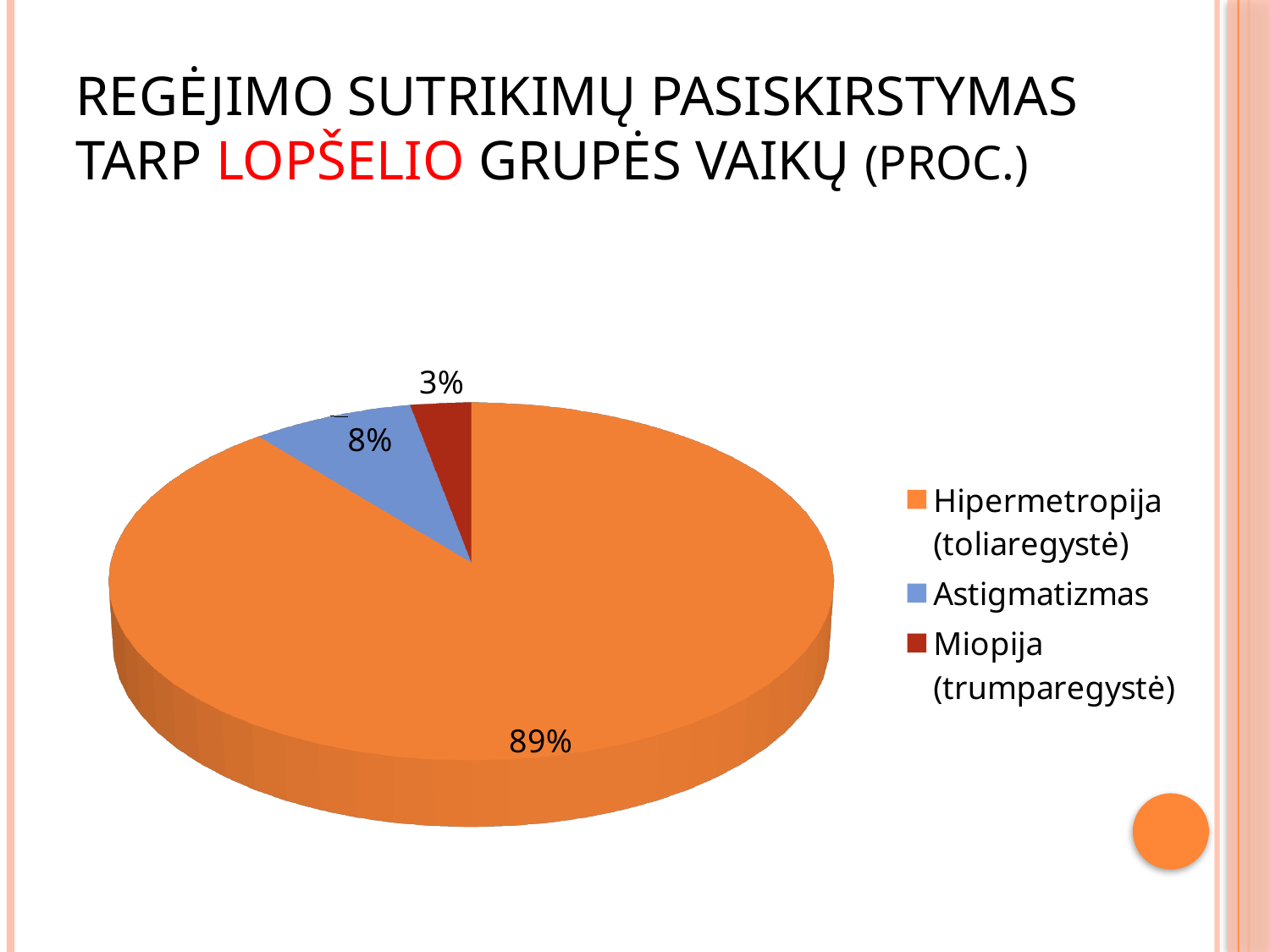
What is the difference in percentage points between Astigmatizmas and Miopija (trumparegystė)? 5 Which category has the smallest share of the pie? Miopija (trumparegystė) What percentage of the pie is Hipermetropija (toliaregystė)? 89% What percentage of the pie is Astigmatizmas? 8% How many categories does the pie chart have? 3 What colour is the slice for Astigmatizmas? blue Which category has the largest share of the pie? Hipermetropija (toliaregystė) What percentage of the pie is Miopija (trumparegystė)? 3% How many entries does the legend list? 3 What is the difference in percentage points between Hipermetropija (toliaregystė) and Astigmatizmas? 81 What kind of chart is shown on the slide? pie chart Which is larger, the share for Astigmatizmas or the share for Miopija (trumparegystė)? Astigmatizmas